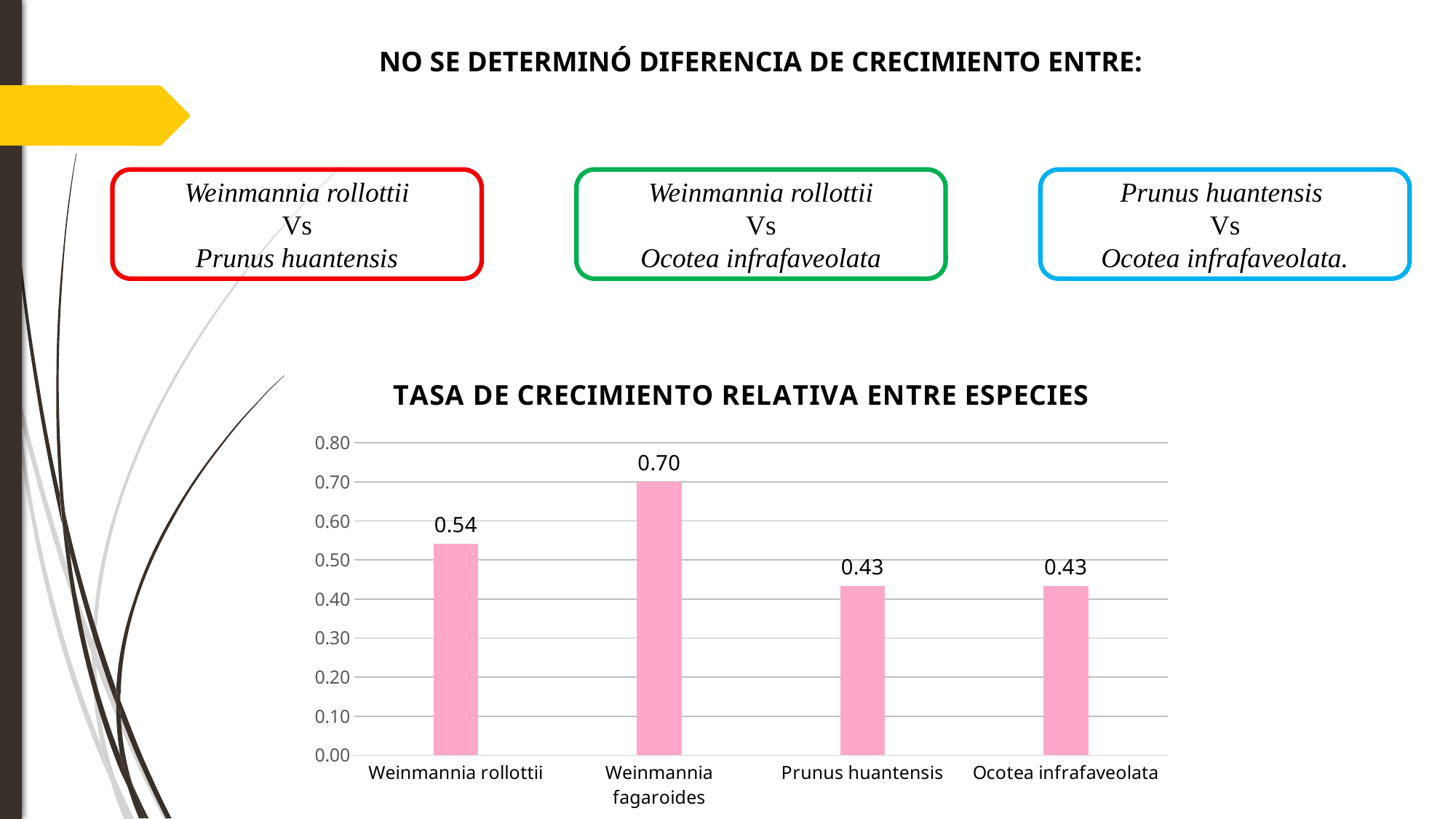
How many species are shown on the x axis of the chart? 4 What is the difference between the values for Weinmannia rollottii and Prunus huantensis? 0.11 What is the relative growth rate value for Weinmannia fagaroides? 0.70 What is the relative growth rate value for Weinmannia rollottii? 0.54 Which species has the highest relative growth rate? Weinmannia fagaroides What is the difference between the values for Weinmannia fagaroides and Weinmannia rollottii? 0.16 What kind of chart is shown on the slide? bar chart What colour are the bars in the chart? pink What is the title of the chart? TASA DE CRECIMIENTO RELATIVA ENTRE ESPECIES Which is larger, the value for Weinmannia rollottii or the value for Ocotea infrafaveolata? Weinmannia rollottii Is the value for Weinmannia fagaroides greater or less than 0.60? greater What is the relative growth rate value for Prunus huantensis? 0.43